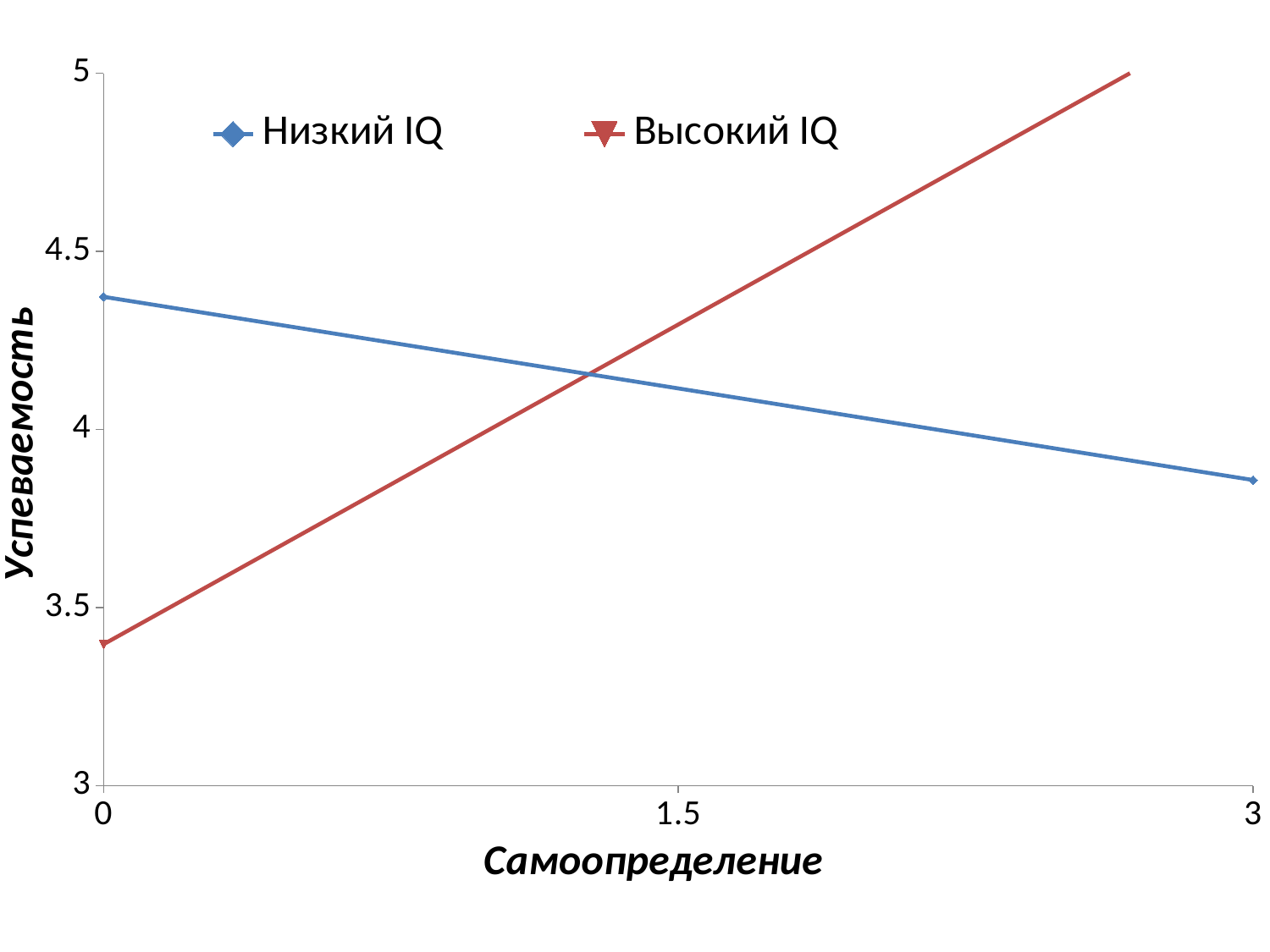
Is the value for Низкий IQ at Самоопределение = 3 greater or less than 4? less Is the value for Высокий IQ at Самоопределение = 1.5 greater or less than 4? greater Does the line for Низкий IQ rise or fall as Самоопределение increases? fall How many series does the legend list? 2 At Самоопределение = 0, which series has the higher Успеваемость, Низкий IQ or Высокий IQ? Низкий IQ Is the value for Высокий IQ at Самоопределение = 0 greater or less than 3.5? less What kind of chart is shown on the slide? line chart What is the title of the vertical axis? Успеваемость At Самоопределение = 3, which series has the higher Успеваемость, Низкий IQ or Высокий IQ? Высокий IQ Does the line for Высокий IQ rise or fall as Самоопределение increases? rise What are the two series named in the legend? Низкий IQ and Высокий IQ